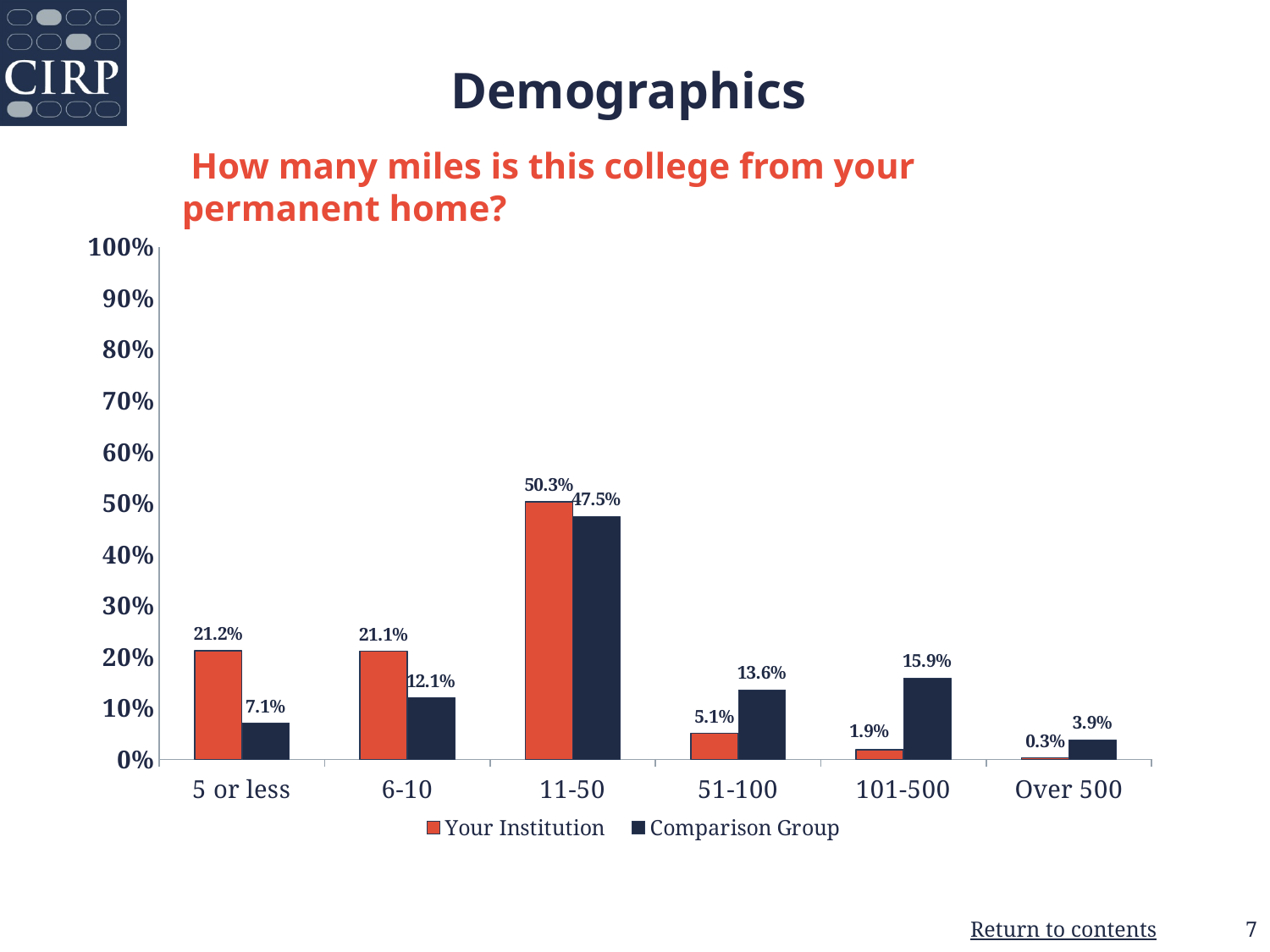
How many series does the legend list? 2 What is the value for Your Institution in the 11-50 category? 50.3% What is the value for Comparison Group in the 101-500 category? 15.9% Is the value for Comparison Group in the 6-10 category greater or less than 20%? less Which category has the highest value for Comparison Group? 11-50 What is the value for Your Institution in the Over 500 category? 0.3% How many categories are shown on the x axis? 6 Which is larger in the 51-100 category, Your Institution or Comparison Group? Comparison Group What is the difference between Your Institution and Comparison Group in the 5 or less category? 14.1% Which category has the lowest value for Your Institution? Over 500 What kind of chart is shown on the slide? bar chart What question does the chart's title ask? How many miles is this college from your permanent home?